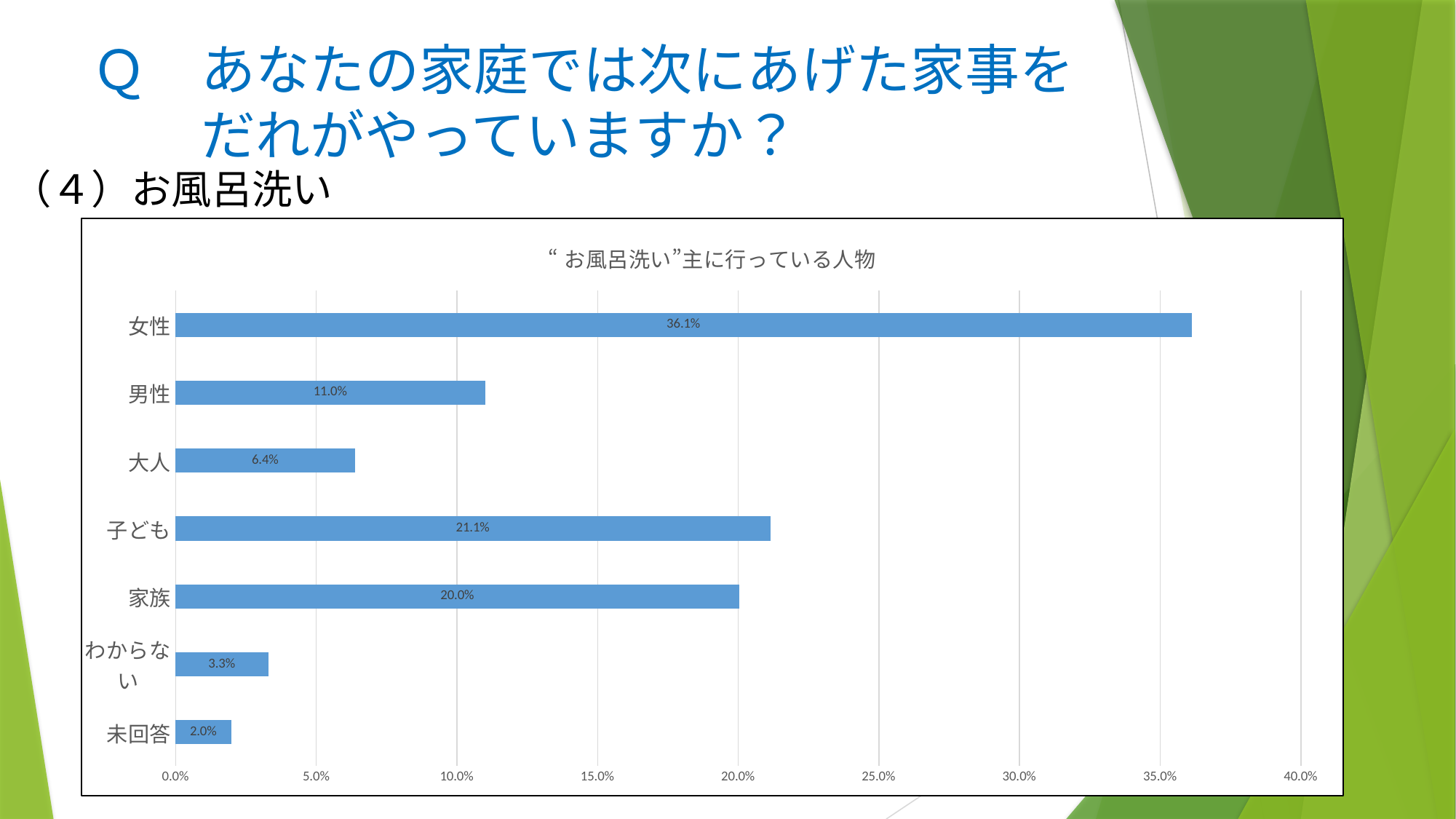
What is the value for 男性? 11.0% What is the title of the chart? “お風呂洗い”主に行っている人物 Which is larger, the value for 大人 or the value for わからない? 大人 What is the value for 女性? 36.1% Is the value for 家族 greater or less than 15.0%? greater How many categories are shown in the chart? 7 What is the difference between the values for 女性 and 男性? 25.1% What kind of chart is shown on the slide? bar chart What is the value for 未回答? 2.0% What is the value for 子ども? 21.1% Which category has the lowest value? 未回答 Which category has the highest value? 女性